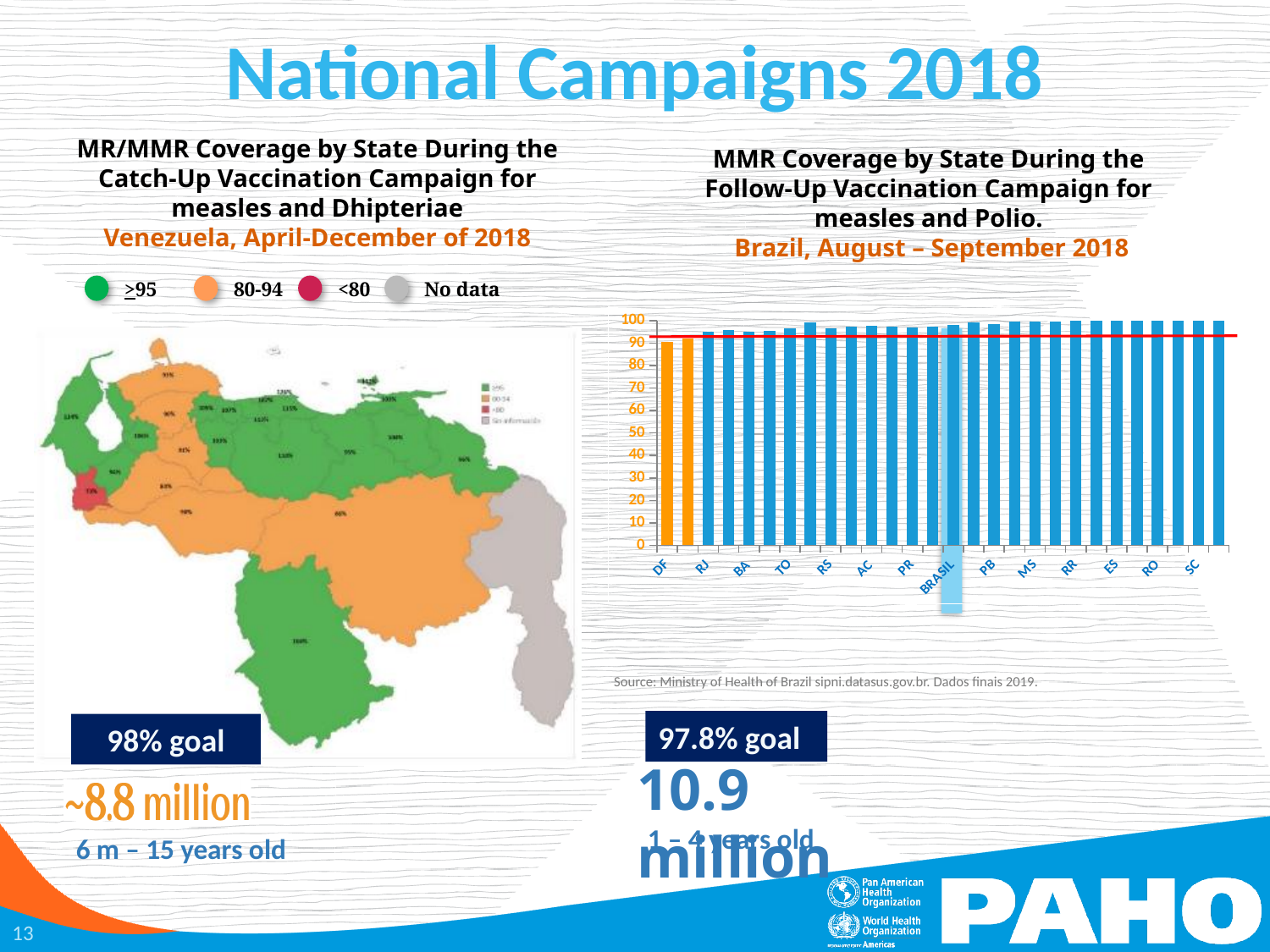
In the Brazil MMR coverage chart, which labeled state has the lowest coverage? DF In the Brazil MMR coverage chart, is the value for SC greater or less than 90? greater In the Brazil MMR coverage chart, which has the larger value, RJ or ES? ES In the Brazil MMR coverage chart, is the value for DF greater or less than 100? less In the Brazil MMR coverage chart, is the value for BRASIL greater or less than 80? greater How many state labels are printed on the x axis of the Brazil MMR coverage chart? 14 In the Brazil MMR coverage chart, which has the larger value, DF or SC? SC What is the highest value shown on the y axis of the Brazil MMR coverage chart? 100 What kind of chart is the MMR Coverage by State chart for Brazil? bar chart